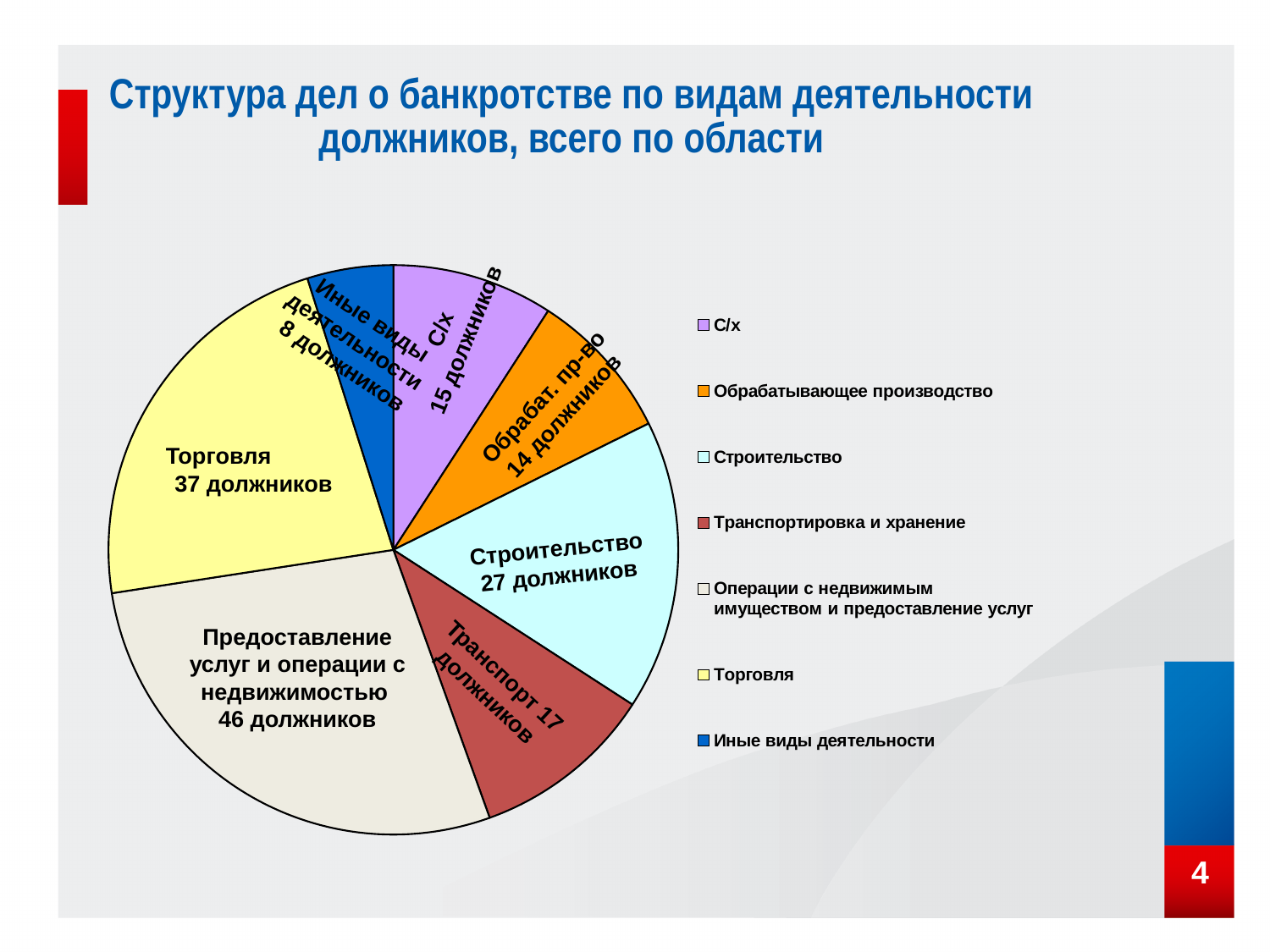
What is the difference in debtors between Торговля and Строительство? 10 Which has more debtors, Обрабат. пр-во or Транспорт? Транспорт How many debtors are in the Транспорт slice? 17 должников How many debtors are in the Строительство slice? 27 должников Which category has the largest number of debtors? Предоставление услуг и операции с недвижимостью (46 должников) How many debtors are in the С/х slice? 15 должников How many entries does the legend list? 7 Which category has the smallest number of debtors? Иные виды деятельности (8 должников) How many debtors are in the Торговля slice? 37 должников What is the title of the slide? Структура дел о банкротстве по видам деятельности должников, всего по области How many slices does the pie chart have? 7 What kind of chart is shown on the slide? pie chart